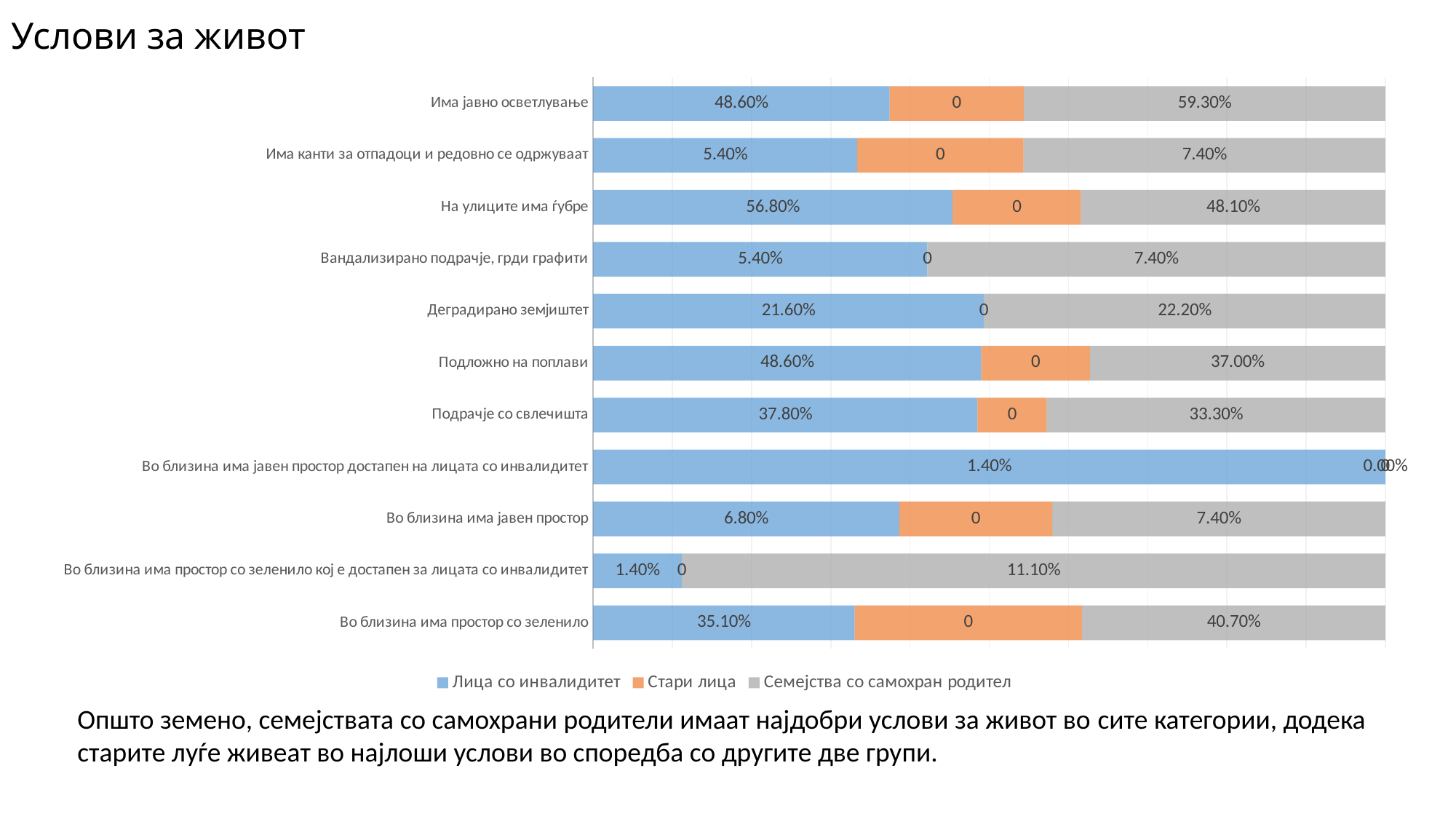
Which category has the highest value for Семејства со самохран родител? Има јавно осветлување How many series does the legend list? 3 What is the title of the slide containing the chart? Услови за живот What is the value for Стари лица in the category Подложно на поплави? 0 What is the value for Семејства со самохран родител in the category На улиците има ѓубре? 48.10% Which category has the highest value for Лица со инвалидитет? На улиците има ѓубре How many categories are plotted on the chart? 11 In the category На улиците има ѓубре, which series has the larger value: Лица со инвалидитет or Семејства со самохран родител? Лица со инвалидитет What type of chart is shown on the slide? Stacked bar chart What is the value for Семејства со самохран родител in the category Во близина има простор со зеленило кој е достапен за лицата со инвалидитет? 11.10% What is the value for Лица со инвалидитет in the category Има јавно осветлување? 48.60% What is the difference between the Семејства со самохран родител value and the Лица со инвалидитет value in the category Има јавно осветлување? 10.70%